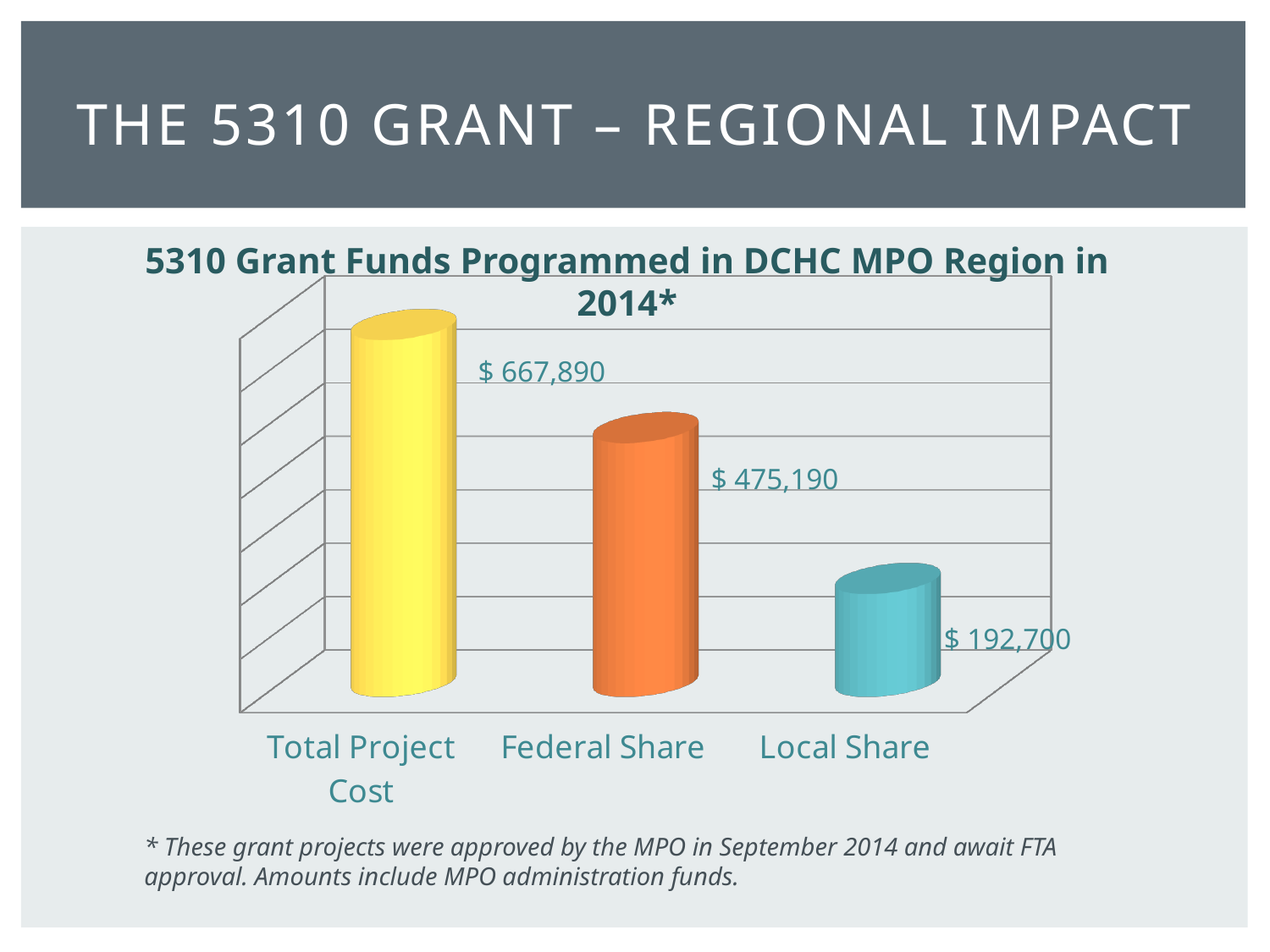
What is the difference between Federal Share and Local Share? $ 282,490 What is the title of the chart? 5310 Grant Funds Programmed in DCHC MPO Region in 2014* Do the values rise or fall from left to right across the categories? Fall How many categories are shown in the chart? 3 Which category has the lowest value? Local Share Which category has the highest value? Total Project Cost What is the difference between Total Project Cost and Federal Share? $ 192,700 What is the value for Federal Share? $ 475,190 What kind of chart is shown on the slide? Bar chart What is the value for Total Project Cost? $ 667,890 Which is larger, Federal Share or Local Share? Federal Share What is the value for Local Share? $ 192,700